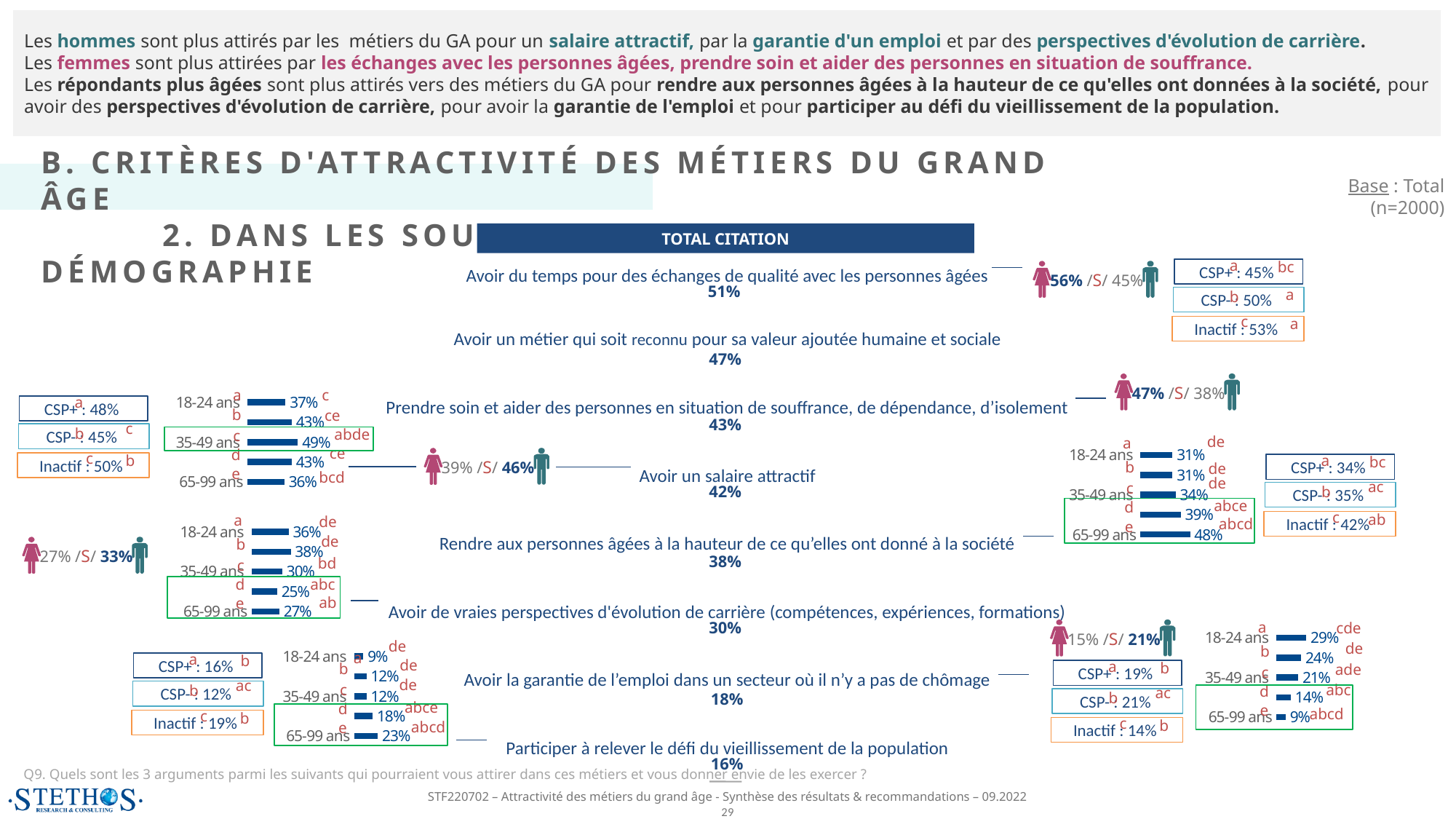
In the bar chart at the lower right of the slide (values 29% to 9%), how many age groups are plotted? 5 In the bar chart at the lower left of the slide (values 9% to 23%), do the values rise or fall from 18-24 ans to 65-99 ans? rise In the bar chart at the middle left of the slide (values 36% to 27%), what is the difference between the values for 18-24 ans and 65-99 ans? 9 percentage points In the central TOTAL CITATION list, what is the total citation percentage for 'Avoir un salaire attractif'? 42% In the bar chart at the lower left of the slide (values 9% to 23%), what is the value for 65-99 ans? 23% In the bar chart at the upper left of the slide (values 37% to 36%), which age group has the highest value? 35-49 ans In the bar chart at the upper left of the slide (values 37% to 36%), what is the value for 18-24 ans? 37% In the bar chart at the middle left of the slide (values 36% to 27%), what is the value for 65-99 ans? 27% In the bar chart at the upper left of the slide (values 37% to 36%), what is the value for 35-49 ans? 49% In the bar chart at the lower right of the slide (values 29% to 9%), which is larger: the value for 18-24 ans or for 65-99 ans? 18-24 ans In the bar chart at the middle right of the slide (values 31% to 48%), which age group has the highest value? 65-99 ans In the central TOTAL CITATION list, which criterion has the lowest total citation percentage? Participer à relever le défi du vieillissement de la population